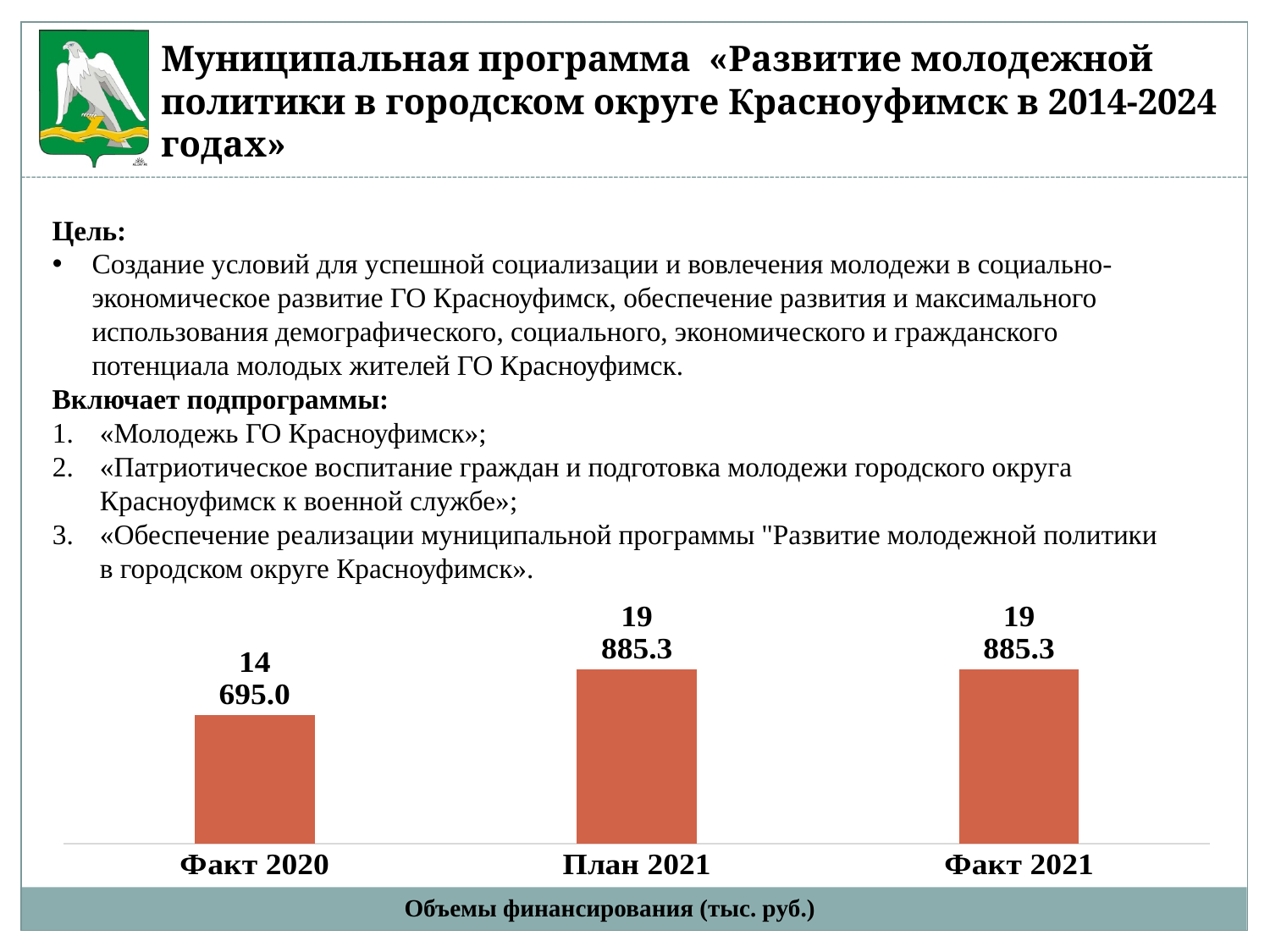
What is the value for Факт 2021? 19 885.3 How many categories are shown in the chart? 3 Which category has the lowest value? Факт 2020 What unit of measurement is stated in the chart caption? тыс. руб. What is the difference between the values for План 2021 and Факт 2020? 5 190.3 Which is larger, the value for Факт 2020 or the value for Факт 2021? Факт 2021 What kind of chart is shown on the slide? Bar chart What is the value for Факт 2020? 14 695.0 What is the value for План 2021? 19 885.3 Does the value rise or fall from Факт 2020 to План 2021? Rise What is the caption shown below the chart? Объемы финансирования (тыс. руб.) Are the values for План 2021 and Факт 2021 equal? Yes